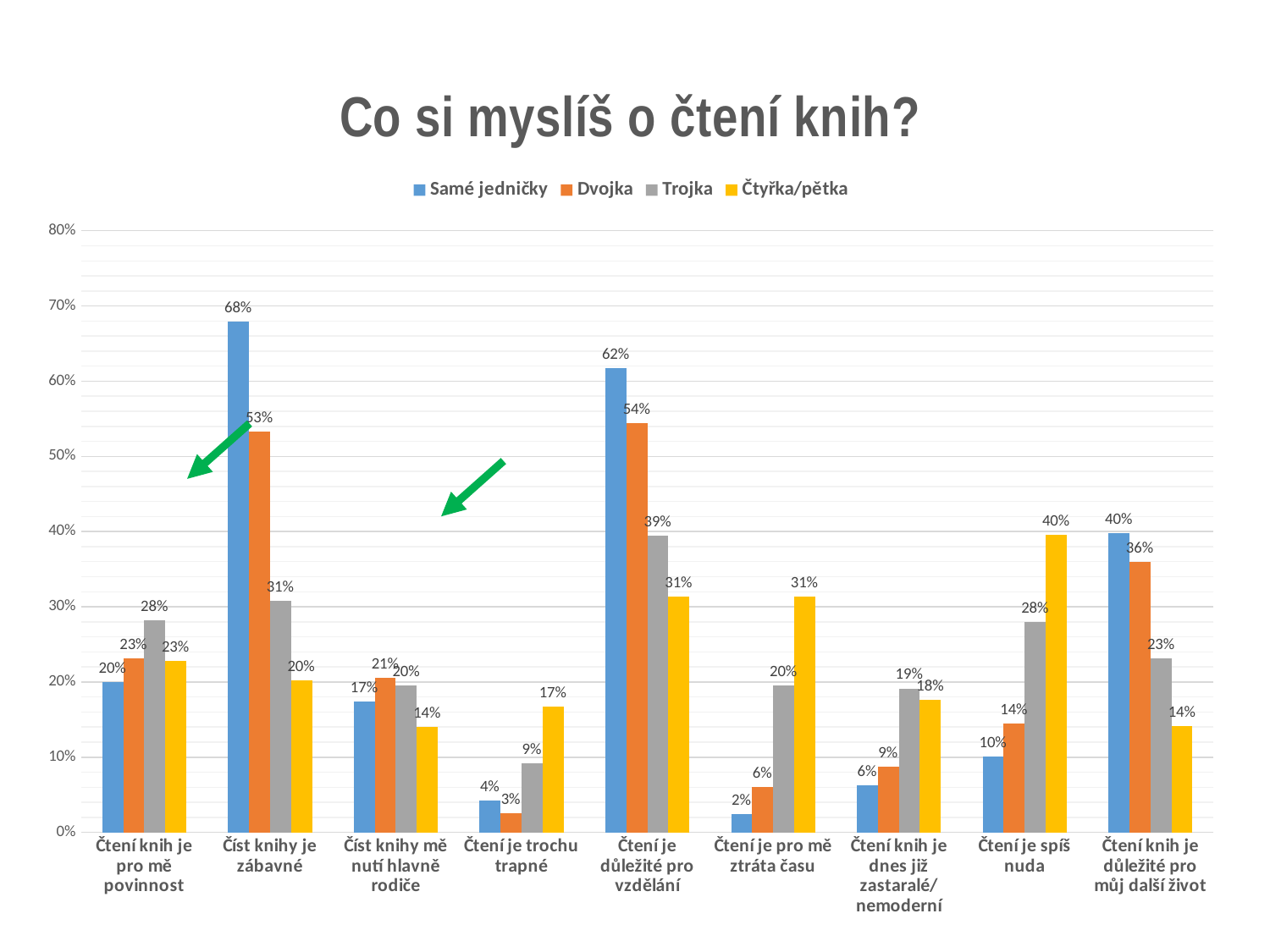
What type of chart is shown on the slide? bar chart What is the value for Samé jedničky in the category 'Číst knihy je zábavné'? 68% What is the title of the chart? Co si myslíš o čtení knih? What is the difference between the Samé jedničky and Dvojka values in the category 'Číst knihy je zábavné'? 15% What is the value for Trojka in the category 'Čtení je důležité pro vzdělání'? 39% Which category has the highest value for Samé jedničky? Číst knihy je zábavné How many categories are shown on the x axis? 9 In the category 'Čtení je pro mě ztráta času', which is larger: the value for Trojka or the value for Čtyřka/pětka? Čtyřka/pětka What is the value for Čtyřka/pětka in the category 'Čtení je spíš nuda'? 40% Which series is shown in yellow in the legend? Čtyřka/pětka How many series does the legend list? 4 Which category has the lowest value for Samé jedničky? Čtení je pro mě ztráta času